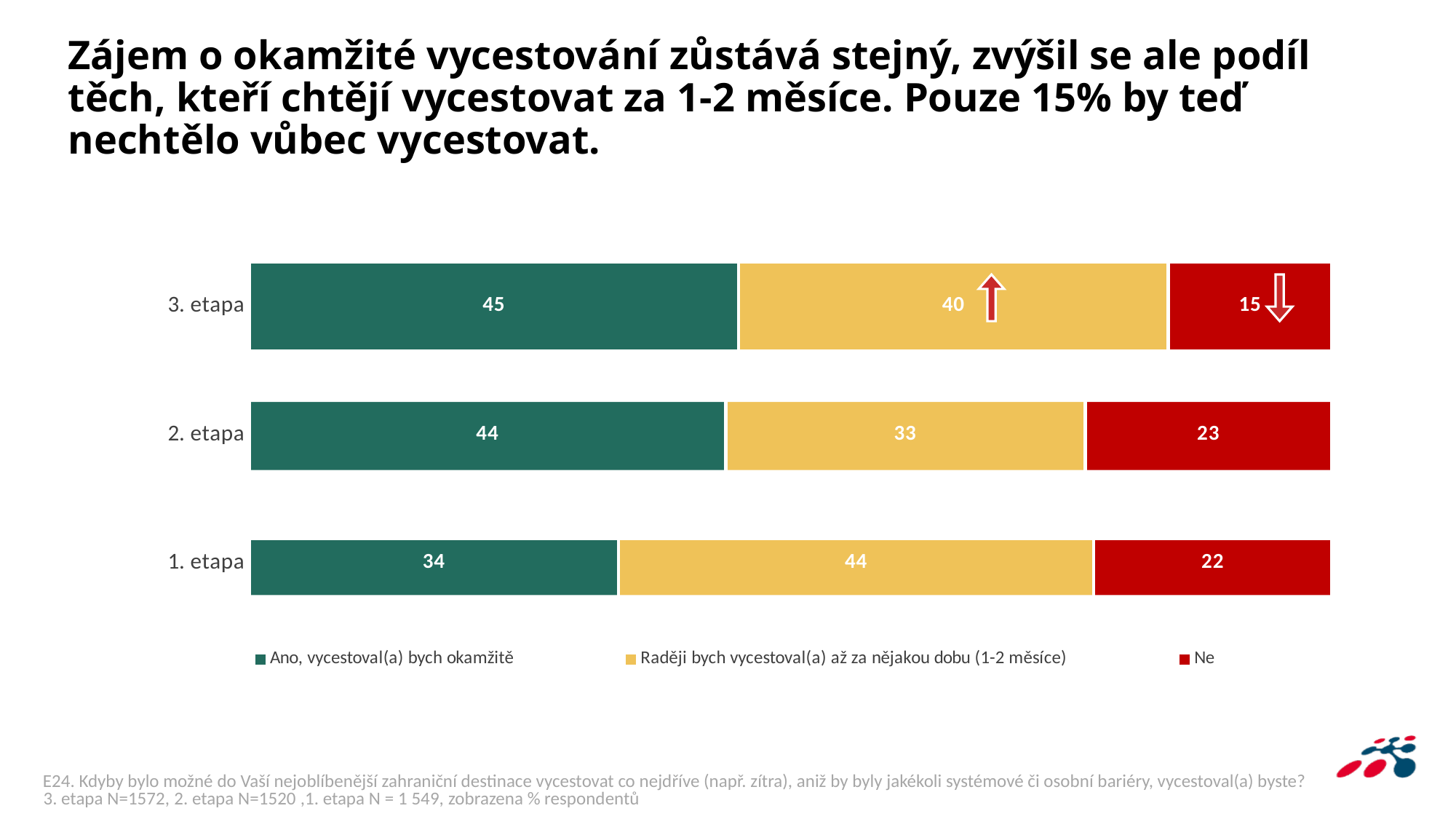
What kind of chart is shown on the slide? Stacked bar chart Which etapa has the lowest value for "Ano, vycestoval(a) bych okamžitě"? 1. etapa What is the value for "Raději bych vycestoval(a) až za nějakou dobu (1-2 měsíce)" in 1. etapa? 44 How many series does the legend list? 3 What is the total of the stacked bar for 1. etapa? 100 What is the value for "Ano, vycestoval(a) bych okamžitě" in 3. etapa? 45 What is the difference between the "Ne" values for 2. etapa and 3. etapa? 8 How many etapa categories are shown in the chart? 3 Which etapa has the highest value for "Ne"? 2. etapa What is the value for "Ne" in 2. etapa? 23 Which is larger: the "Raději bych vycestoval(a) až za nějakou dobu (1-2 měsíce)" value in 3. etapa or in 2. etapa? 3. etapa What colour represents the "Ne" series in the chart? Red